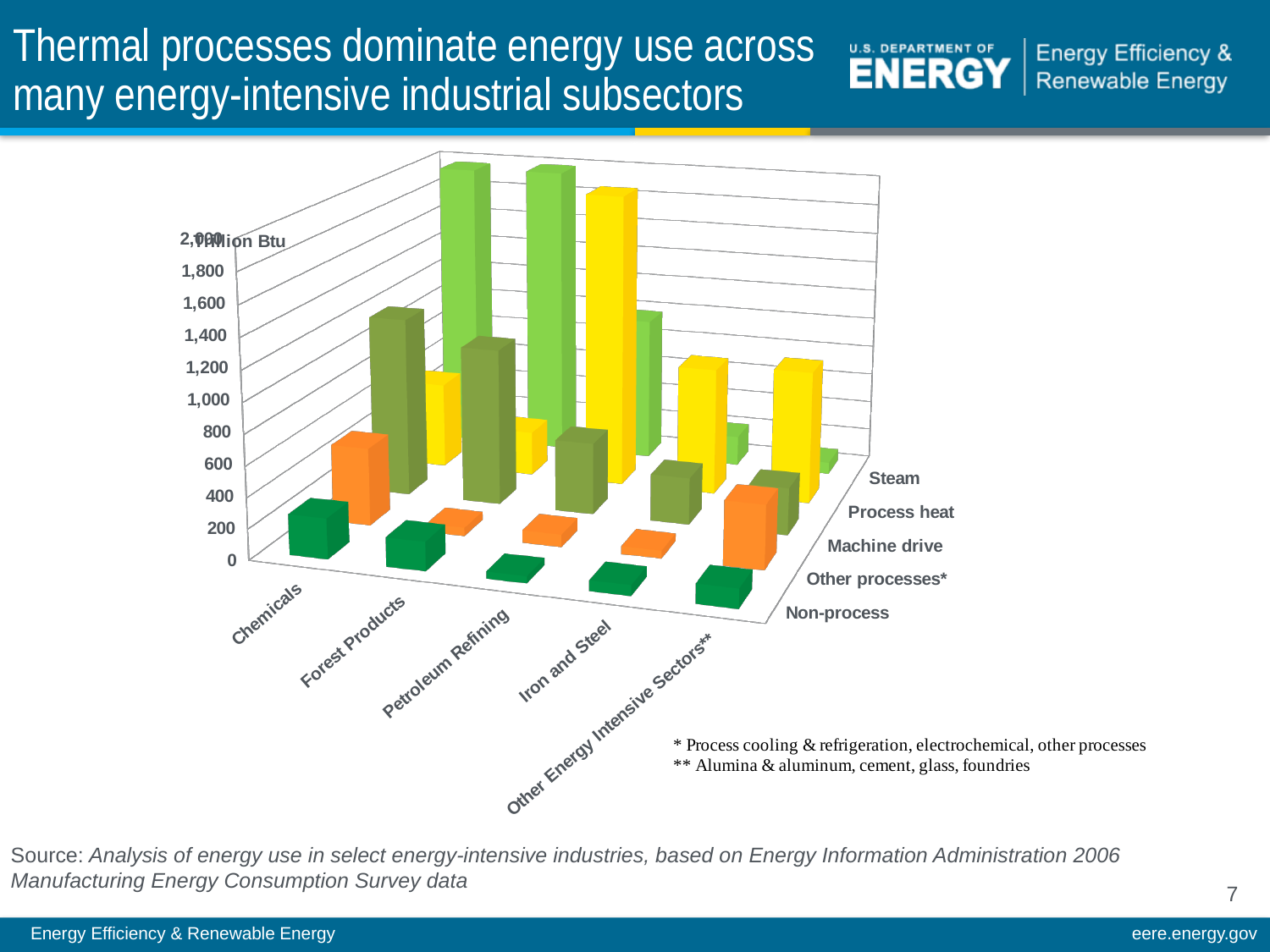
Which subsector has the tallest Process heat bar? Petroleum Refining Is the Process heat value for Petroleum Refining greater or less than 1,400? greater Which subsector has the shortest Process heat bar? Forest Products How many industrial subsectors are shown along the category axis of the chart? 5 What unit is shown on the vertical axis of the chart? Trillion Btu What kind of chart is shown on the slide? Bar chart Which subsector has the tallest Non-process bar? Chemicals Which subsector has the tallest Machine drive bar? Chemicals Is the Steam value for Chemicals greater or less than 1,600? greater Which subsector has the shortest Steam bar? Other Energy Intensive Sectors** Is the Process heat value for Forest Products greater or less than 800? less How many energy-use series (Steam, Process heat, etc.) does the chart show? 5